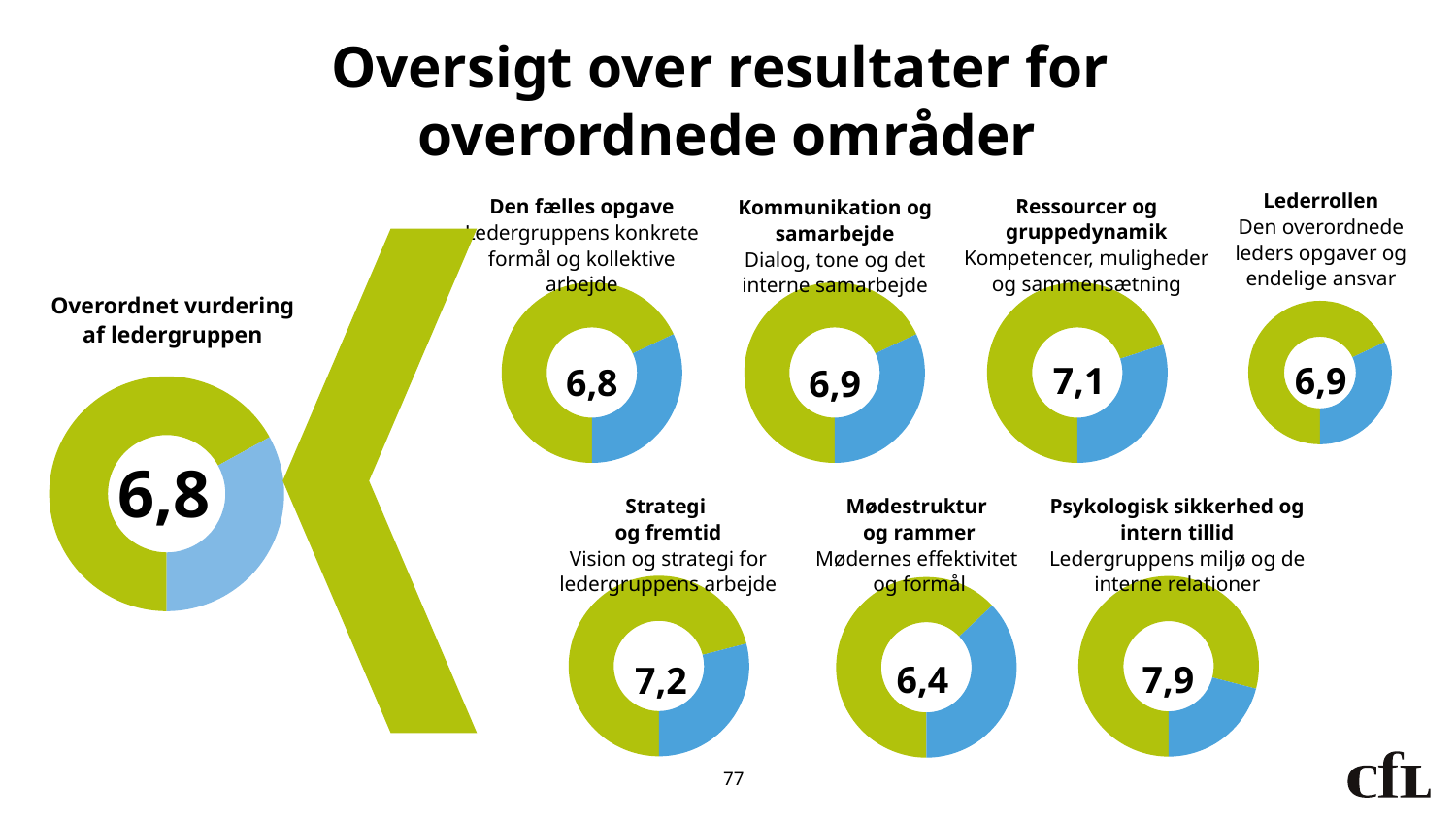
Which area has the highest score among the charts on the slide? Psykologisk sikkerhed og intern tillid What score is shown in the 'Kommunikation og samarbejde' chart? 6,9 What score is shown in the 'Den fælles opgave' chart? 6,8 What score is shown in the 'Strategi og fremtid' chart? 7,2 Which area has the lowest score among the charts on the slide? Mødestruktur og rammer What score is shown in the 'Overordnet vurdering af ledergruppen' chart? 6,8 What score is shown in the 'Lederrollen' chart? 6,9 What score is shown in the 'Ressourcer og gruppedynamik' chart? 7,1 What score is shown in the 'Psykologisk sikkerhed og intern tillid' chart? 7,9 What is the difference between the score for 'Psykologisk sikkerhed og intern tillid' and the score for 'Mødestruktur og rammer'? 1,5 How many donut charts are shown on the slide? 8 What score is shown in the 'Mødestruktur og rammer' chart? 6,4